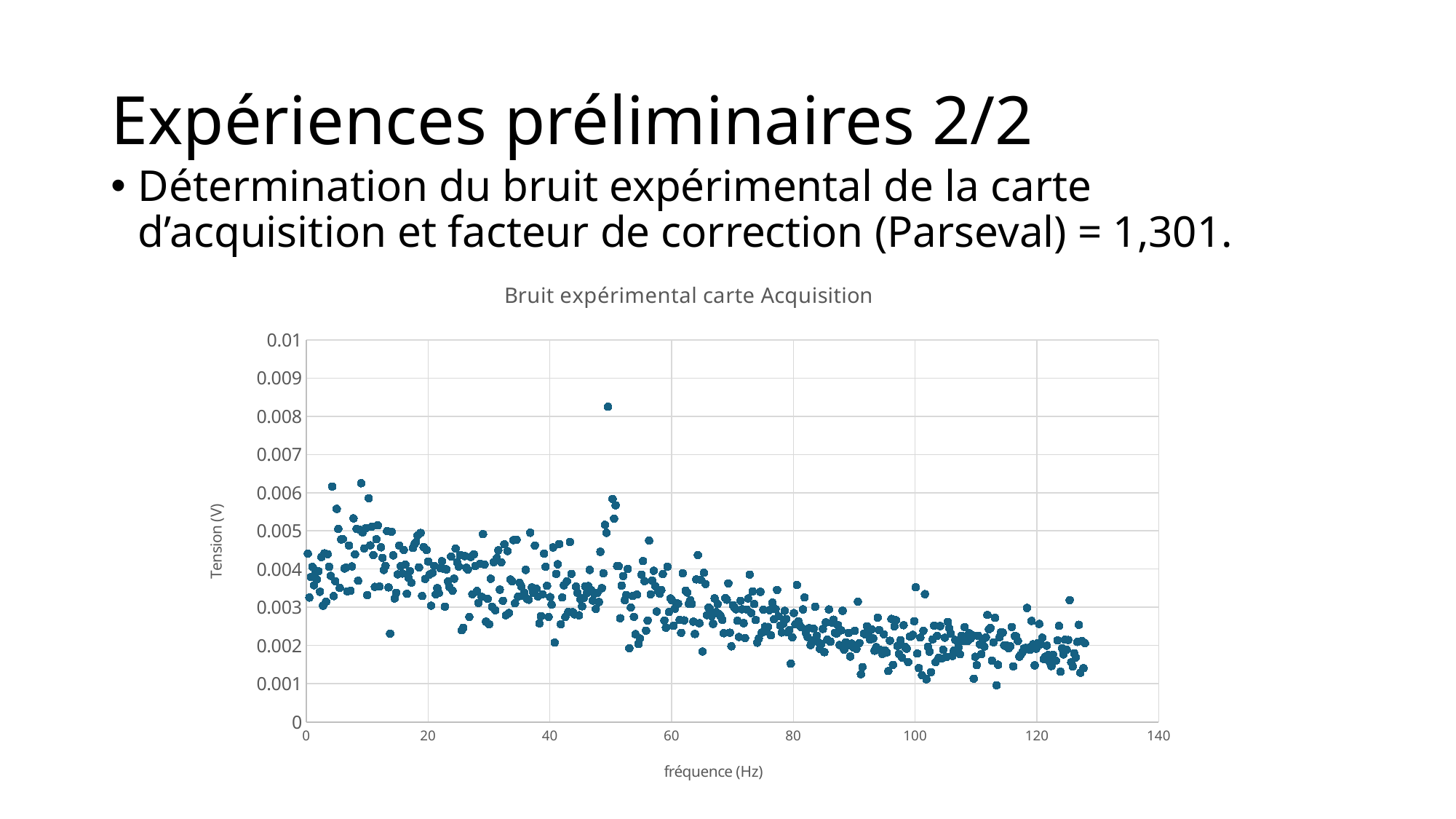
Are most of the plotted values near 0 Hz greater or less than 0.003? greater Is the lowest plotted value on the chart greater or less than 0.002? less Is the highest plotted value on the chart greater or less than 0.008? greater Are the plotted values near 10 Hz generally larger or smaller than those near 110 Hz? larger Do the plotted values generally rise or fall as frequency increases along the x axis? fall What kind of chart is shown on the slide? scatter chart What is the label of the vertical axis of the chart? Tension (V) What is the title of the chart? Bruit expérimental carte Acquisition